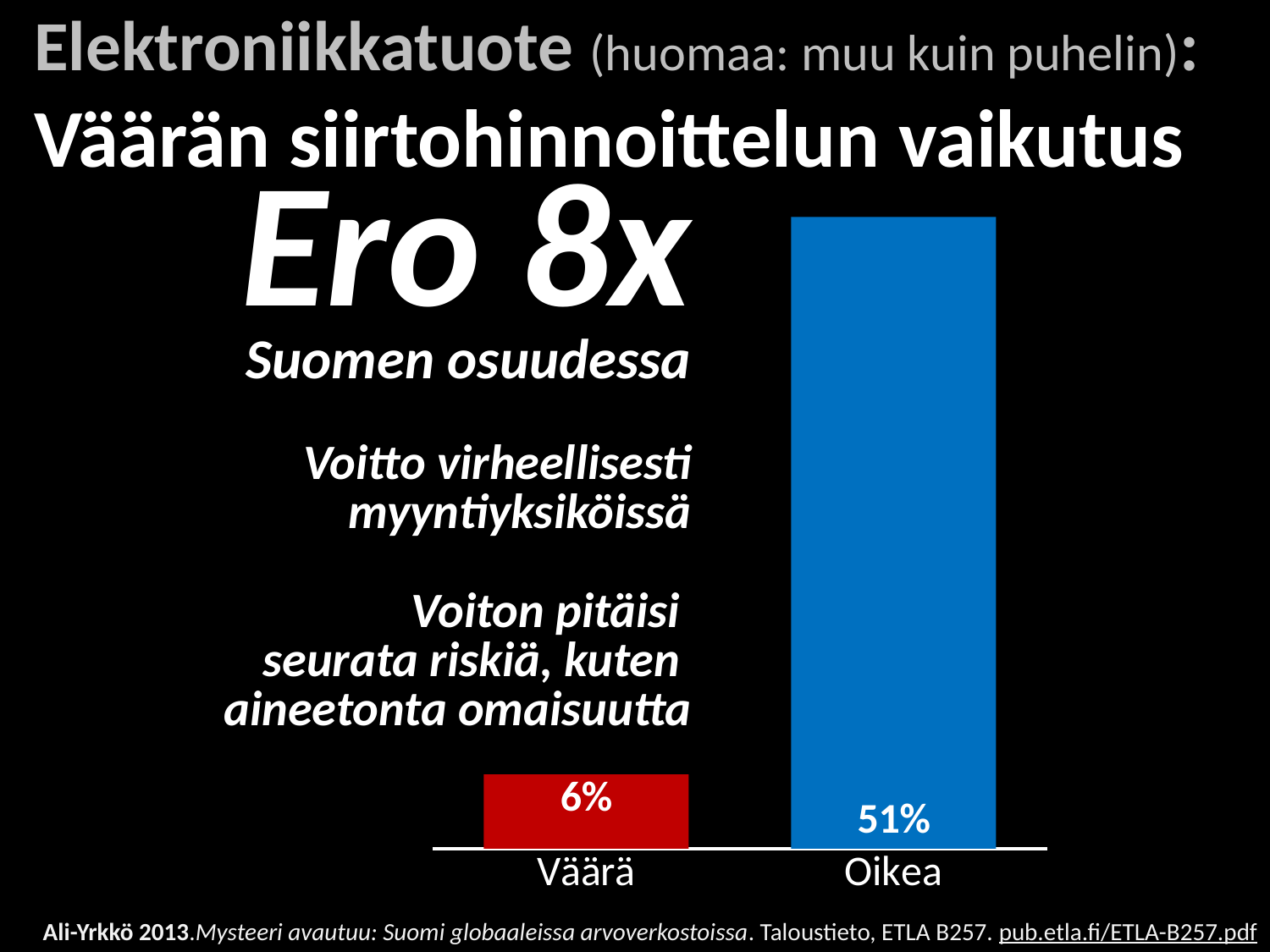
What colour is the bar for Väärä? Red Which category has the highest value? Oikea What kind of chart is shown on the slide? Bar chart What colour is the bar for Oikea? Blue What is the difference between the values for Oikea and Väärä? 45% Which is larger, the value for Väärä or the value for Oikea? Oikea Which category has the lowest value? Väärä What is the value for Oikea? 51% Do the values rise or fall from Väärä to Oikea? Rise What is the value for Väärä? 6% How many categories are shown in the chart? 2